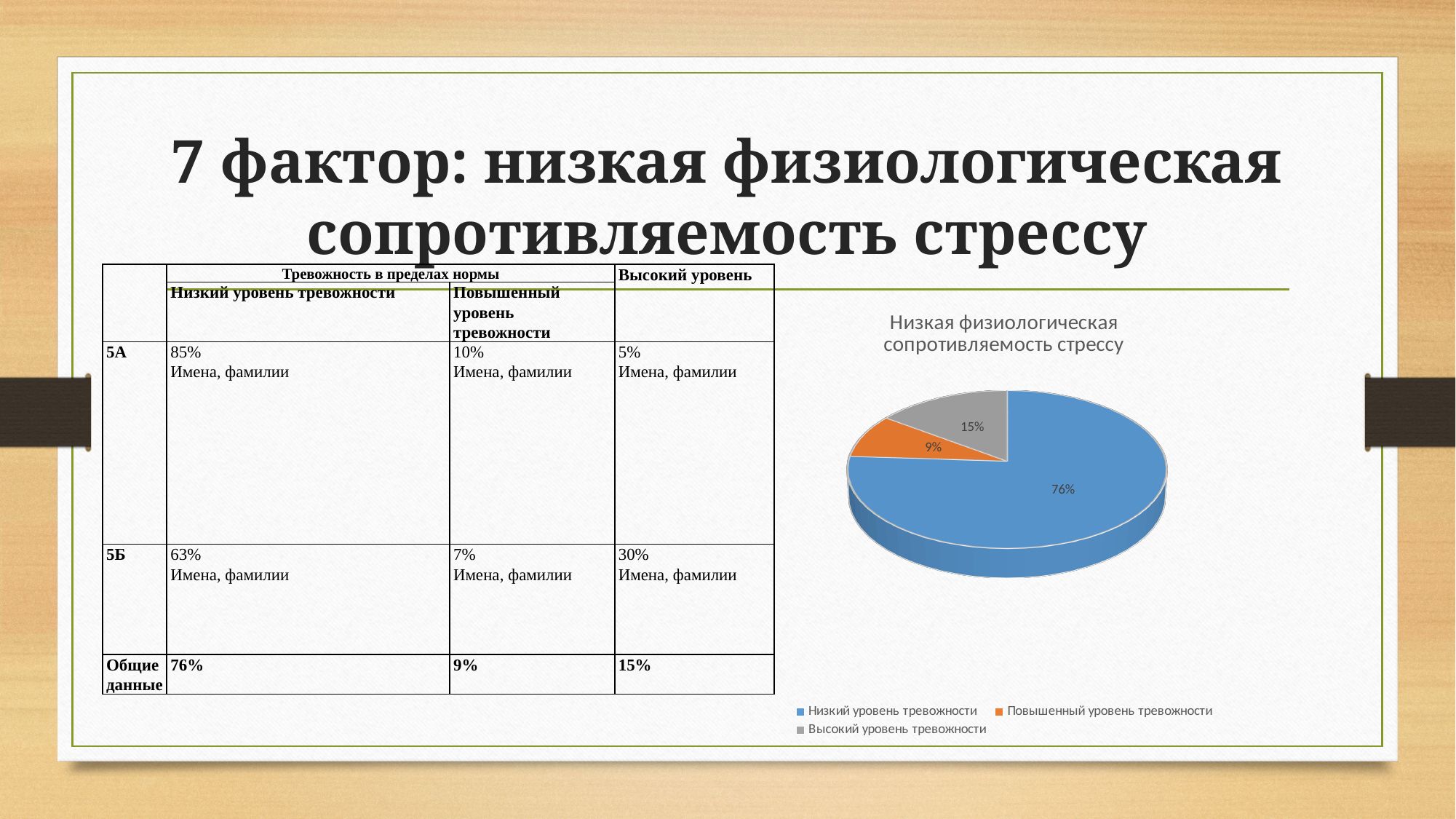
What kind of chart is shown on the slide? Pie chart What is the difference between the shares for "Низкий уровень тревожности" and "Высокий уровень тревожности" in the pie chart? 61% What colour is the slice for "Повышенный уровень тревожности" in the pie chart? Orange Which category has the smallest slice in the pie chart? Повышенный уровень тревожности Which category has the largest slice in the pie chart? Низкий уровень тревожности Which is larger in the pie chart: the share for "Высокий уровень тревожности" or the share for "Повышенный уровень тревожности"? Высокий уровень тревожности How many entries does the legend of the pie chart list? 3 What is the title of the pie chart? Низкая физиологическая сопротивляемость стрессу What share of the pie chart is labelled for "Высокий уровень тревожности"? 15% What share of the pie chart is labelled for "Низкий уровень тревожности"? 76% How many slices does the pie chart have? 3 What share of the pie chart is labelled for "Повышенный уровень тревожности"? 9%